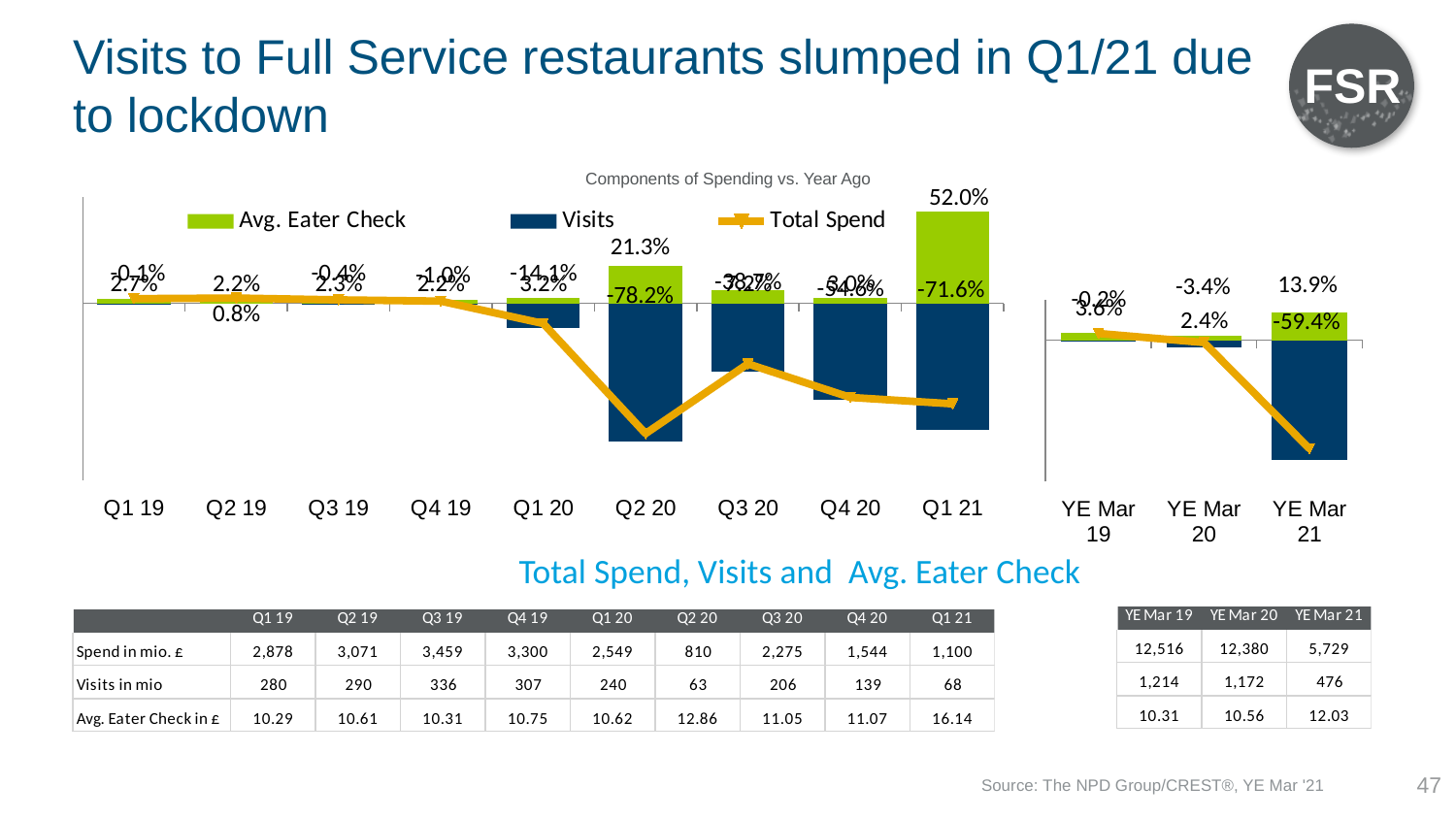
In the chart on the right, what is the Visits value for YE Mar 21? -59.4% In the 'Components of Spending vs. Year Ago' chart, what is the Visits value for Q2 20? -78.2% What kind of chart is the 'Components of Spending vs. Year Ago' chart? Combination bar and line chart In the 'Components of Spending vs. Year Ago' chart, what is the Avg. Eater Check value for Q1 21? 52.0% How many quarters are shown on the x axis of the 'Components of Spending vs. Year Ago' chart? 9 In the 'Components of Spending vs. Year Ago' chart, which quarter has the highest Avg. Eater Check value? Q1 21 In the 'Components of Spending vs. Year Ago' chart, what is the Visits value for Q1 21? -71.6% In the 'Components of Spending vs. Year Ago' chart, which quarter has the lowest Visits value? Q2 20 In the 'Components of Spending vs. Year Ago' chart, what is the difference between the Avg. Eater Check values for Q1 21 and Q2 20? 30.7 percentage points In the chart on the right, what is the Avg. Eater Check value for YE Mar 21? 13.9% In the 'Components of Spending vs. Year Ago' chart, what is the Avg. Eater Check value for Q2 20? 21.3% How many series does the legend of the 'Components of Spending vs. Year Ago' chart list? 3